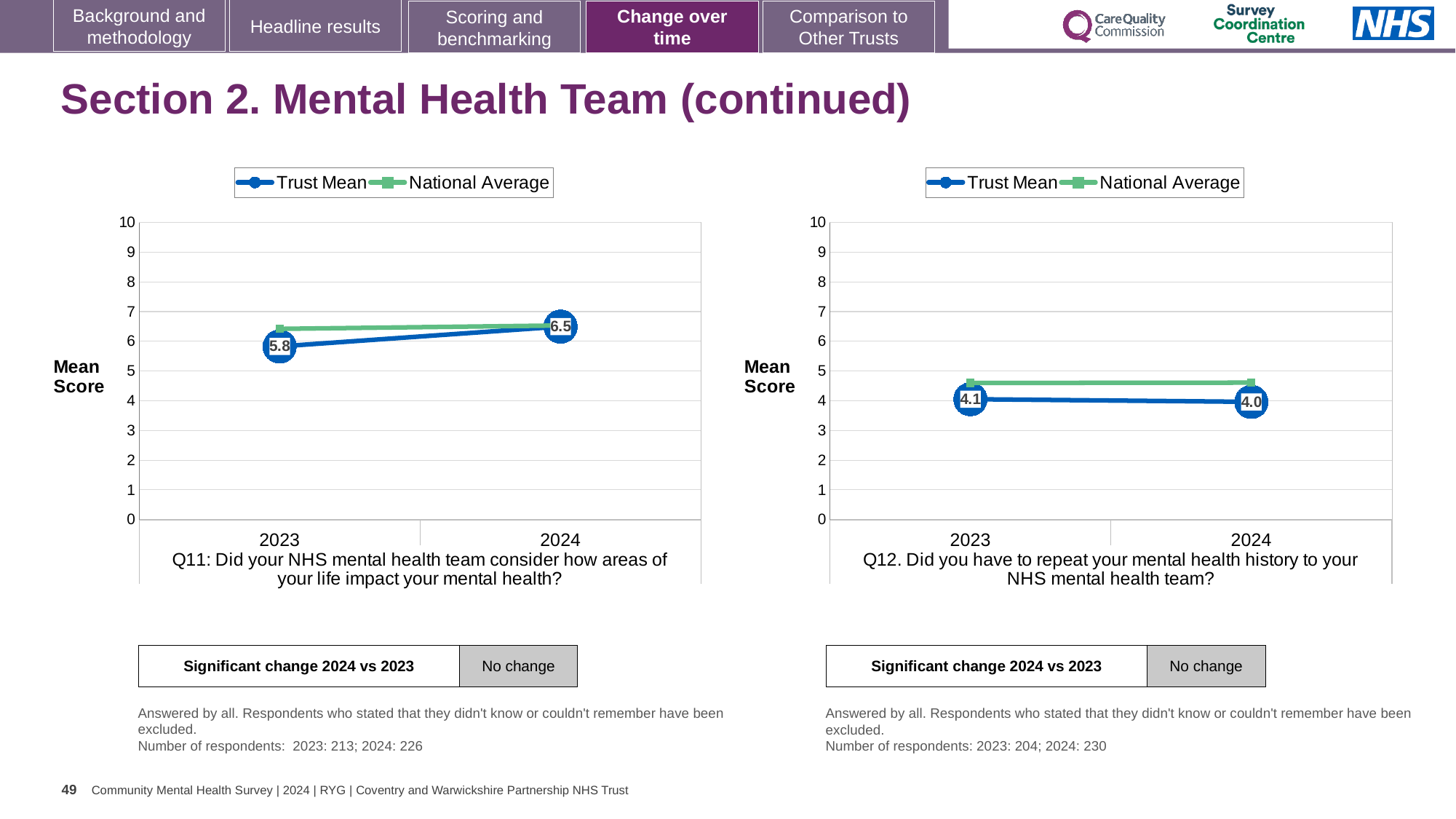
On the Q12 chart, what is the Trust Mean score for 2024? 4.0 On the Q12 chart, does the Trust Mean rise or fall from 2023 to 2024? fall On the Q11 chart, what is the Trust Mean score for 2024? 6.5 How many series does the legend of the Q12 chart list? 2 On the Q11 chart, by how much did the Trust Mean change from 2023 to 2024? 0.7 On the Q11 chart, is the National Average value for 2023 greater or less than 6? greater On the Q12 chart, is the National Average value for 2023 greater or less than 4? greater On the Q12 chart, what is the Trust Mean score for 2023? 4.1 On the Q12 chart, which series has the higher value in 2023, Trust Mean or National Average? National Average On the Q11 chart, does the Trust Mean rise or fall from 2023 to 2024? rise What kind of chart is the Q11 chart? line chart On the Q11 chart, what is the Trust Mean score for 2023? 5.8